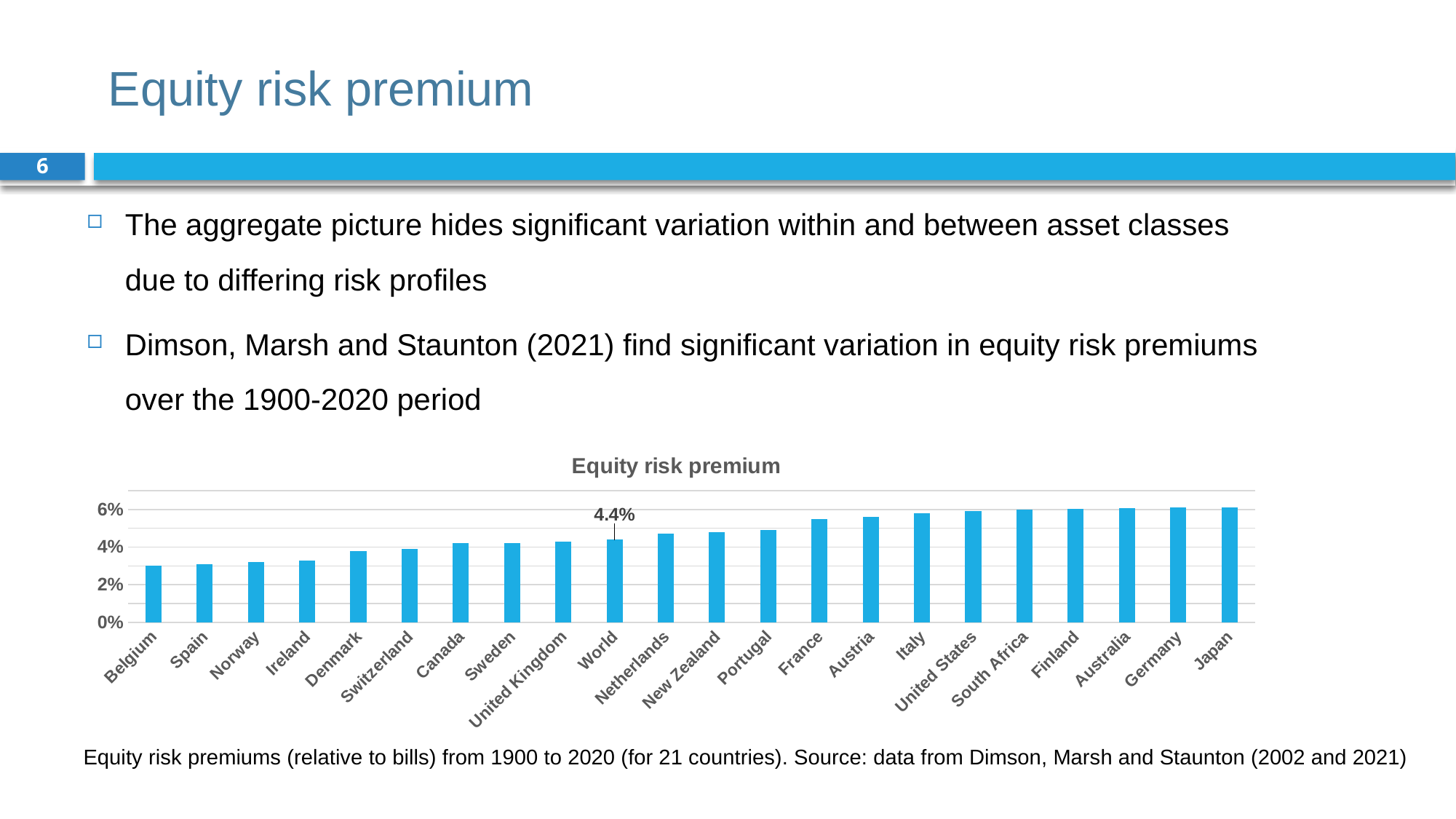
Which has the larger equity risk premium, Canada or France? France Is the value for Japan greater or less than 4%? greater Do the bar values rise or fall moving from left to right along the x axis? rise How many bars (categories) are plotted in the chart? 22 Is the value for Belgium greater or less than 4%? less What kind of chart is shown on the slide? bar chart Which has the larger equity risk premium, Japan or Belgium? Japan What colour are the bars in the chart? blue What is the title of the chart? Equity risk premium Is the value for France greater or less than 4%? greater What is the equity risk premium value shown for World? 4.4%